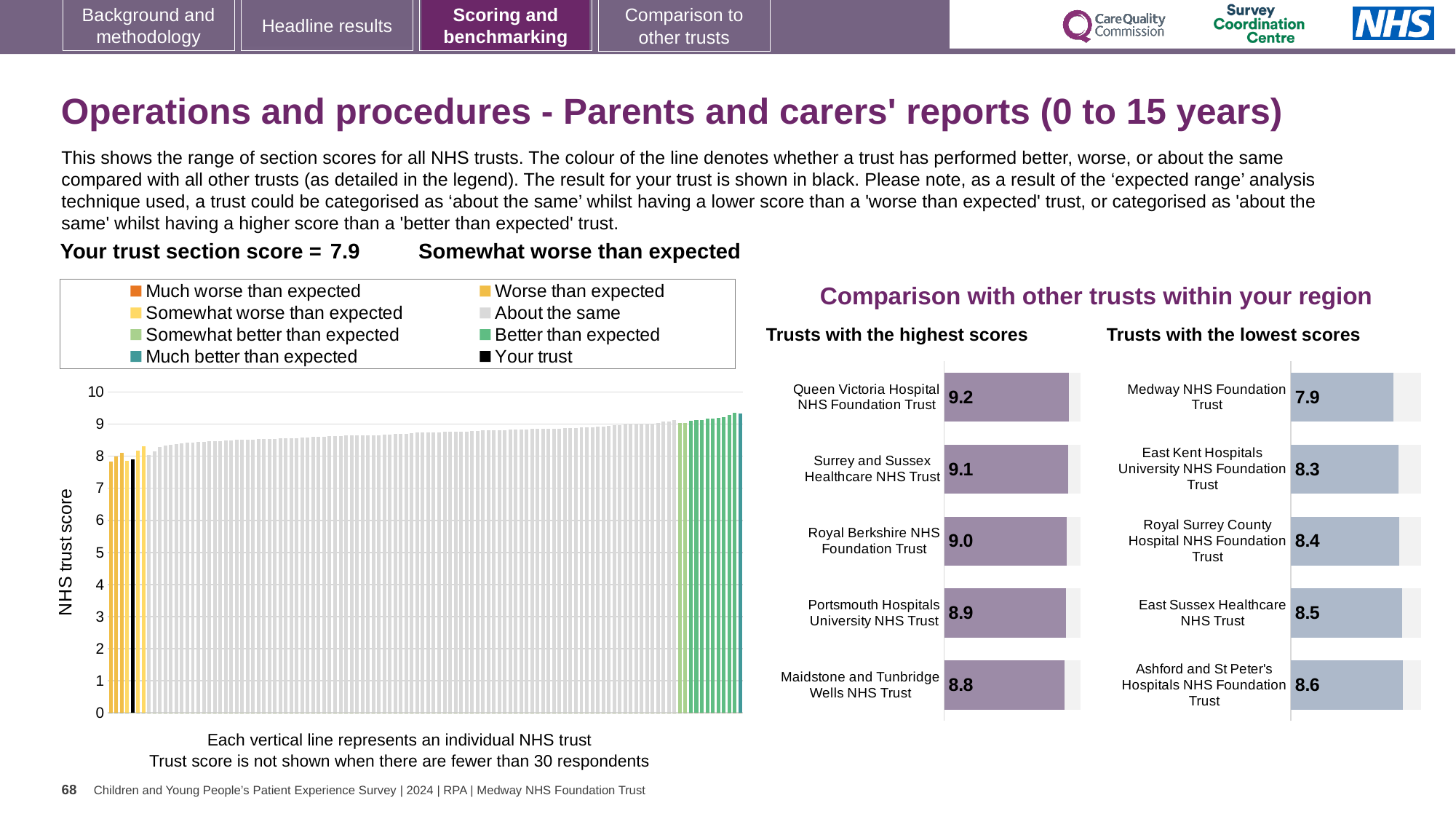
In the 'Trusts with the lowest scores' chart, which trust has the lowest score? Medway NHS Foundation Trust In the NHS trust score chart on the left, what colour represents 'Your trust'? Black What kind of chart is the 'Trusts with the lowest scores' chart? Bar chart How many entries does the legend of the NHS trust score chart on the left list? 8 In the 'Trusts with the lowest scores' chart, which has the higher score: Royal Surrey County Hospital NHS Foundation Trust or East Sussex Healthcare NHS Trust? East Sussex Healthcare NHS Trust How many trusts are listed in the 'Trusts with the highest scores' chart? 5 In the 'Trusts with the lowest scores' chart, what is the difference between the scores of Ashford and St Peter's Hospitals NHS Foundation Trust and Medway NHS Foundation Trust? 0.7 In the 'Trusts with the highest scores' chart, which trust has the lowest score shown? Maidstone and Tunbridge Wells NHS Trust In the 'Trusts with the highest scores' chart, what is the difference between the scores of Queen Victoria Hospital NHS Foundation Trust and Maidstone and Tunbridge Wells NHS Trust? 0.4 In the 'Trusts with the lowest scores' chart, what is the score for East Kent Hospitals University NHS Foundation Trust? 8.3 In the NHS trust score chart on the left, do the trust scores rise or fall from left to right? Rise In the 'Trusts with the highest scores' chart, what is the score for Queen Victoria Hospital NHS Foundation Trust? 9.2